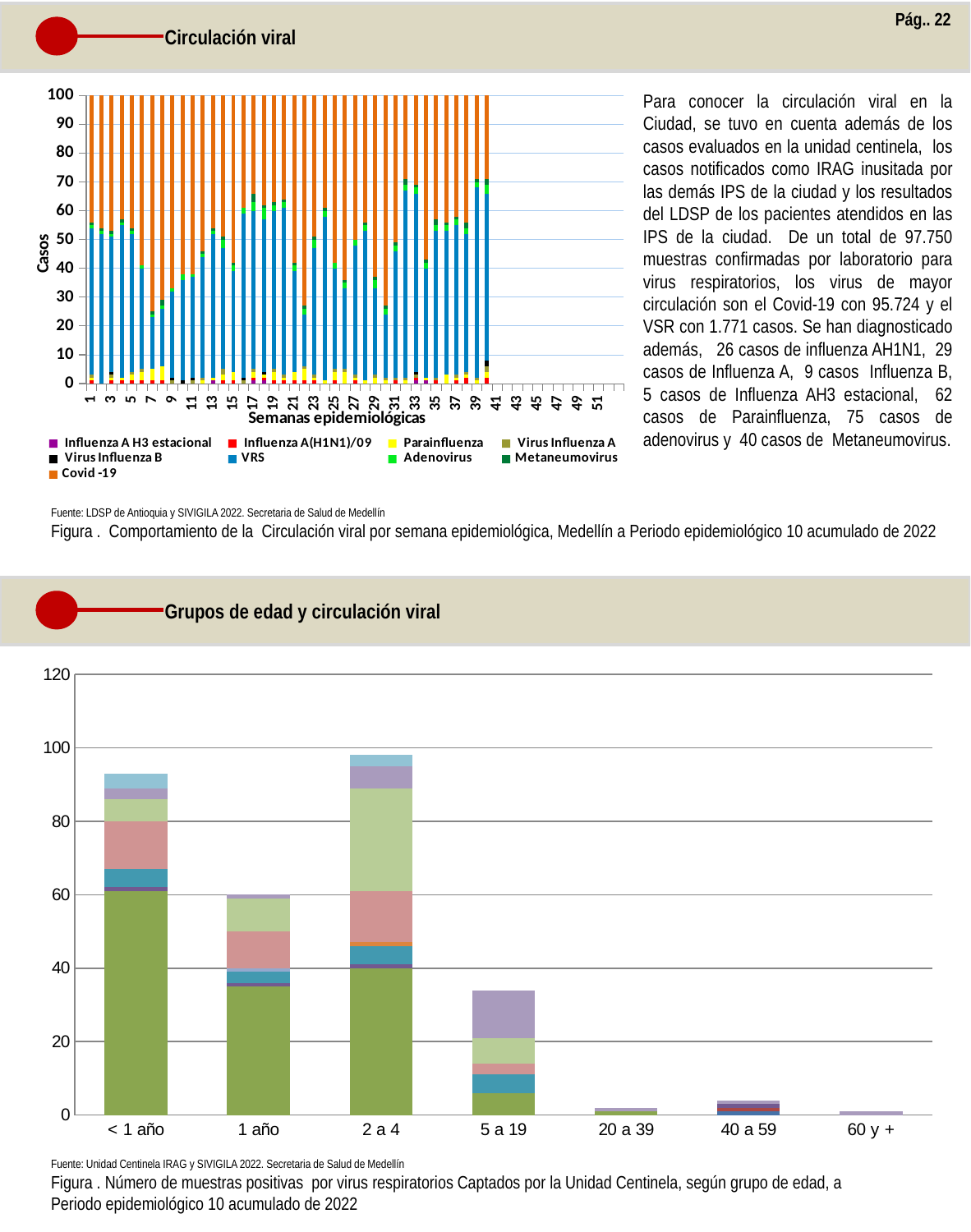
In the top chart (Circulación viral por semana epidemiológica), which series is shown in orange? Covid -19 How many age-group categories are shown on the x axis of the bottom chart (muestras positivas según grupo de edad)? 7 In the bottom chart (muestras positivas según grupo de edad), is the total for '20 a 39' greater or less than 20? less In the bottom chart (muestras positivas según grupo de edad), is the total for '5 a 19' greater or less than 40? less In the bottom chart (muestras positivas según grupo de edad), which total bar is larger: '< 1 año' or '1 año'? < 1 año In the bottom chart (muestras positivas según grupo de edad), which age group has the lowest total bar? 60 y + In the bottom chart (muestras positivas según grupo de edad), is the total for '< 1 año' greater or less than 80? greater In the bottom chart (muestras positivas según grupo de edad), which age group has the highest total bar? 2 a 4 How many series does the legend of the top chart (Circulación viral por semana epidemiológica) list? 9 In the top chart (Circulación viral por semana epidemiológica), what is the label of the y axis? Casos What kind of chart is the top chart, 'Comportamiento de la Circulación viral por semana epidemiológica'? Bar chart What kind of chart is the bottom chart, 'Número de muestras positivas por virus respiratorios según grupo de edad'? Bar chart